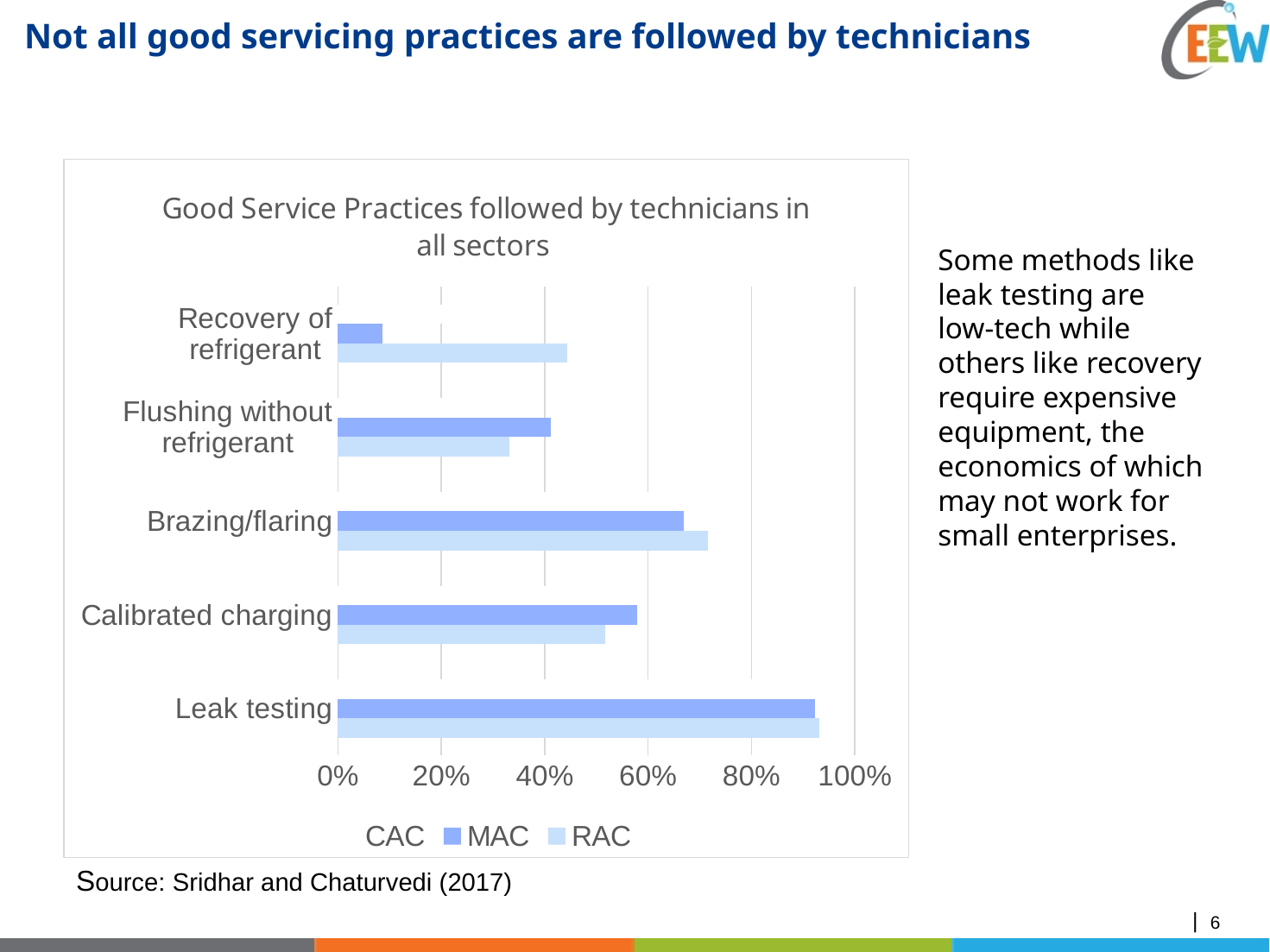
Which service practice has the lowest MAC value? Recovery of refrigerant How many series does the chart legend list? 3 What is the title of the chart? Good Service Practices followed by technicians in all sectors What kind of chart is shown on the slide? bar chart Is the MAC value for Leak testing greater or less than 80%? greater Is the MAC value for Recovery of refrigerant greater or less than 20%? less How many service practices (categories) are listed on the chart? 5 Is the RAC value for Brazing/flaring greater or less than 60%? greater Which service practice has the lowest RAC value? Flushing without refrigerant For Flushing without refrigerant, which series has the larger value, MAC or RAC? MAC Which service practice has the highest MAC value? Leak testing For Recovery of refrigerant, which series has the larger value, MAC or RAC? RAC